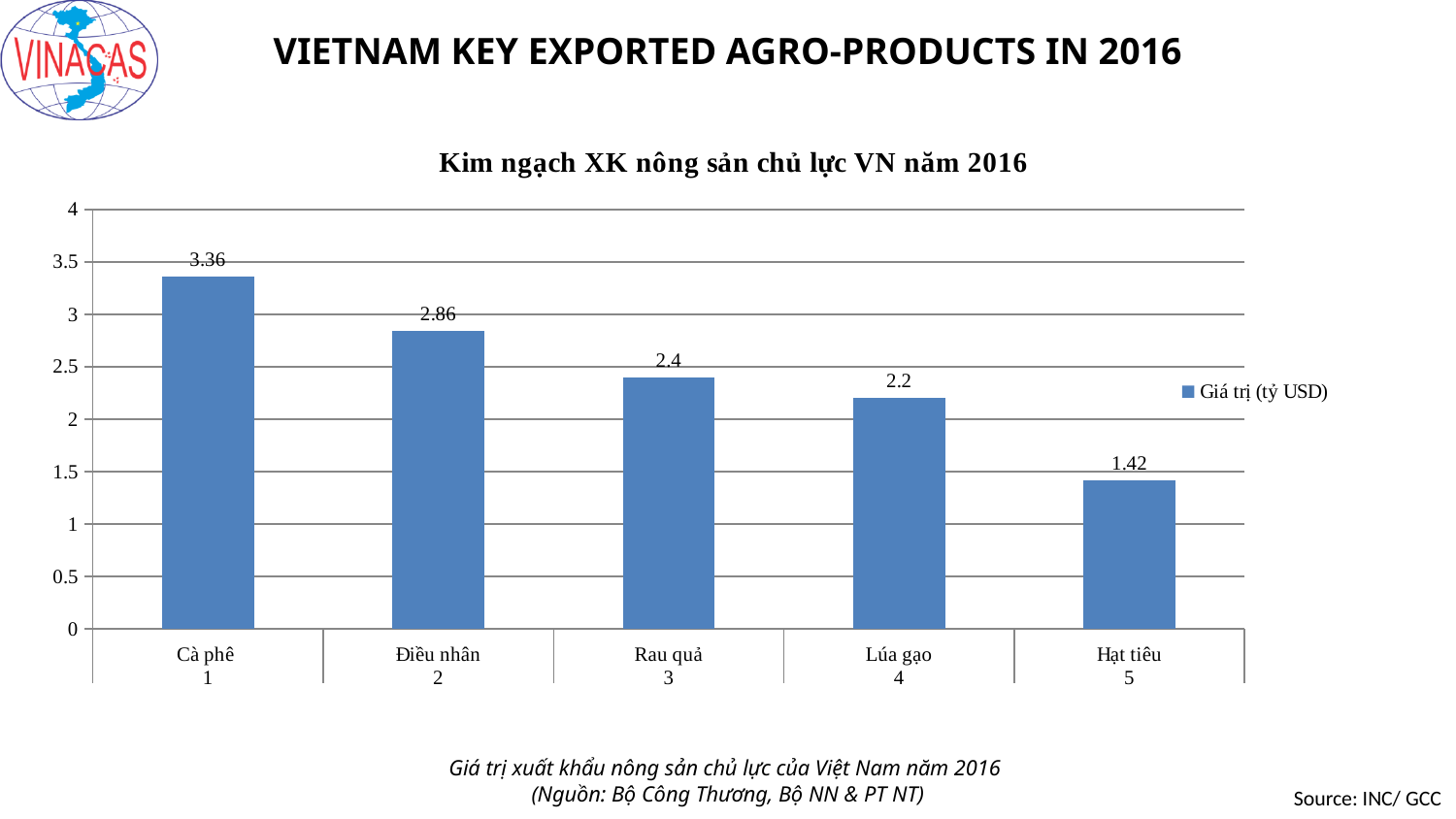
What is the value for Hạt tiêu? 1.42 Which is larger, the value for Rau quả or the value for Hạt tiêu? Rau quả Which category has the lowest value? Hạt tiêu Which category has the highest value? Cà phê What is the legend entry for the series? Giá trị (tỷ USD) What is the value for Cà phê? 3.36 What is the difference between the values for Rau quả and Lúa gạo? 0.2 How many series does the legend list? 1 How many categories are shown in the chart? 5 What kind of chart is shown? Bar chart What is the difference between the values for Cà phê and Điều nhân? 0.5 What is the value for Điều nhân? 2.86